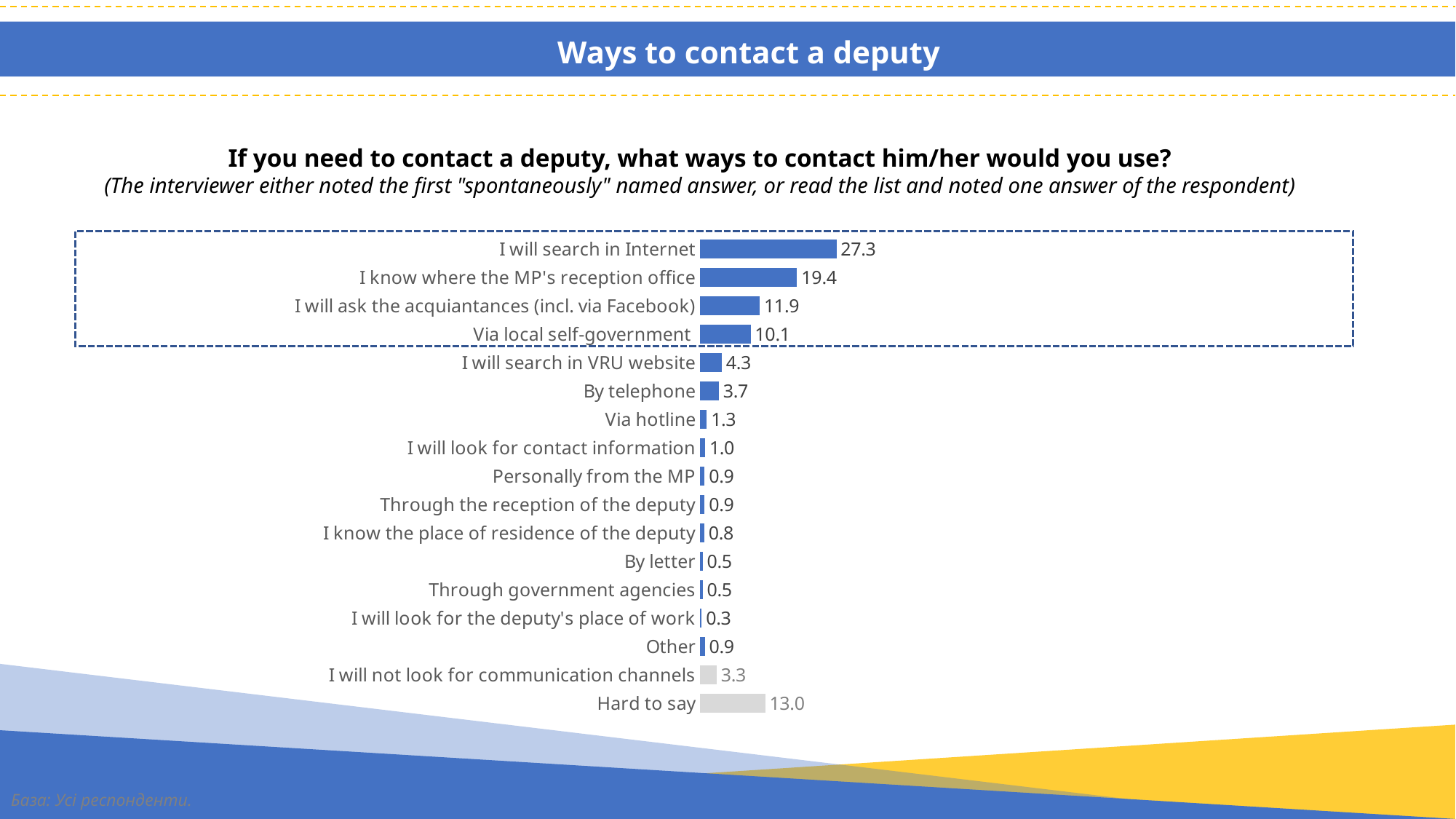
What is the value for "Via local self-government"? 10.1 Which category has the lowest value? I will look for the deputy's place of work Which is larger: "I will ask the acquiantances (incl. via Facebook)" or "Via local self-government"? I will ask the acquiantances (incl. via Facebook) What is the difference between "Hard to say" and "I will search in VRU website"? 8.7 What type of chart is shown on the slide? bar chart Which way of contacting a deputy has the highest value? I will search in Internet What is the value for "I will search in Internet"? 27.3 Which two categories are shown with grey bars instead of blue? I will not look for communication channels; Hard to say What is the value for "Hard to say"? 13.0 What is the difference between "I will search in Internet" and "I know where the MP's reception office"? 7.9 What is the value for "By telephone"? 3.7 How many categories are shown in the chart? 17